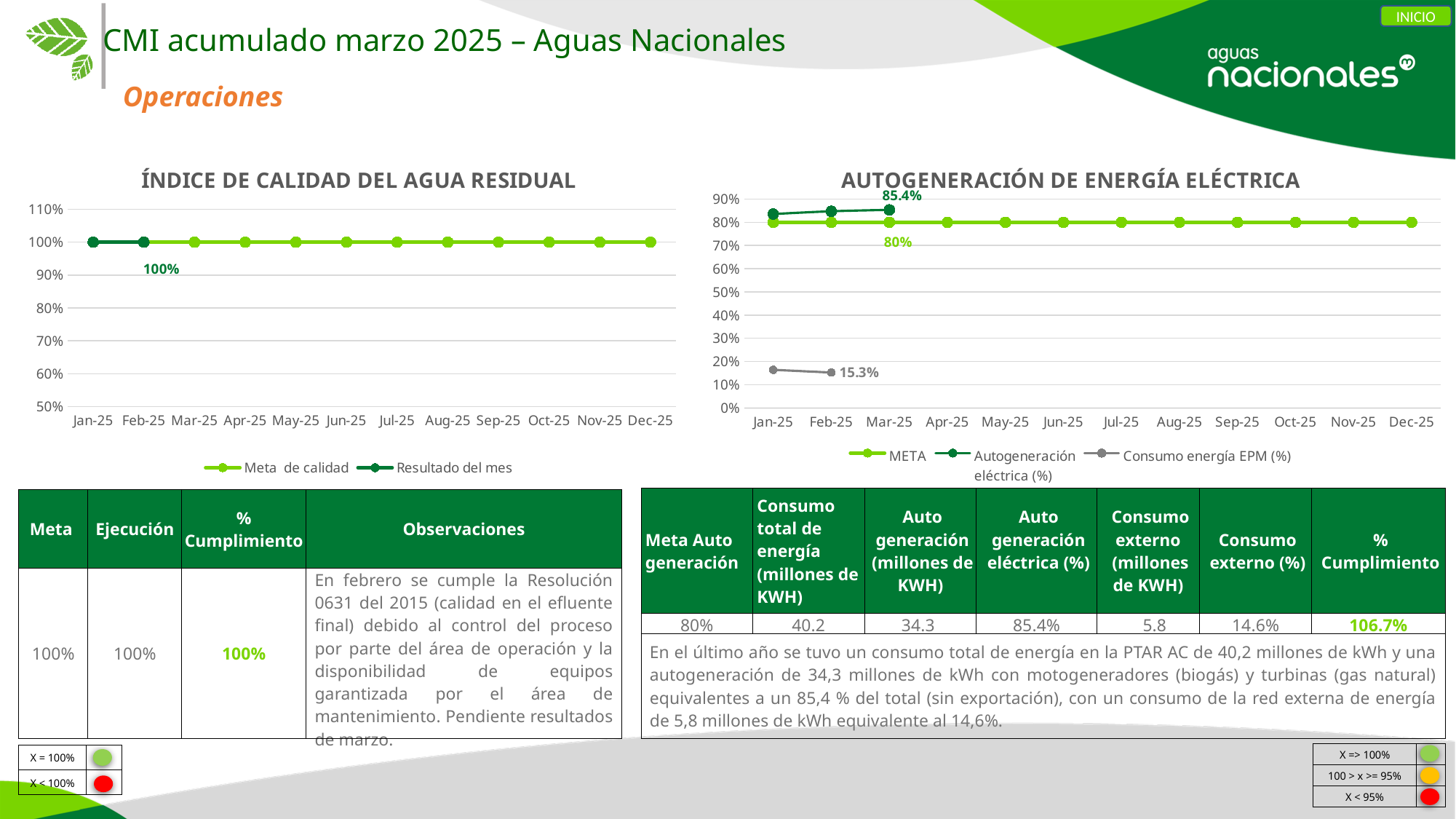
How many months are shown on the x axis of the 'ÍNDICE DE CALIDAD DEL AGUA RESIDUAL' chart? 12 In the 'AUTOGENERACIÓN DE ENERGÍA ELÉCTRICA' chart, what is the labelled value of 'Consumo energía EPM (%)' in Feb-25? 15.3% How many series does the legend of the 'AUTOGENERACIÓN DE ENERGÍA ELÉCTRICA' chart list? 3 In the 'ÍNDICE DE CALIDAD DEL AGUA RESIDUAL' chart, what is the labelled value of 'Resultado del mes' in Feb-25? 100% What kind of chart is the 'ÍNDICE DE CALIDAD DEL AGUA RESIDUAL' chart? Line chart In the 'AUTOGENERACIÓN DE ENERGÍA ELÉCTRICA' chart, which is higher in Mar-25: 'Autogeneración eléctrica (%)' or META? Autogeneración eléctrica (%) How many series does the legend of the 'ÍNDICE DE CALIDAD DEL AGUA RESIDUAL' chart list? 2 In the 'AUTOGENERACIÓN DE ENERGÍA ELÉCTRICA' chart, does the META line rise, fall or stay flat from Jan-25 to Dec-25? Stays flat In the 'AUTOGENERACIÓN DE ENERGÍA ELÉCTRICA' chart, what is the labelled value of the META line? 80% In the 'AUTOGENERACIÓN DE ENERGÍA ELÉCTRICA' chart, is the value for 'Consumo energía EPM (%)' in Jan-25 greater or less than 20%? less In the 'AUTOGENERACIÓN DE ENERGÍA ELÉCTRICA' chart, by how much does the Mar-25 'Autogeneración eléctrica (%)' value exceed the META value? 5.4% In the 'AUTOGENERACIÓN DE ENERGÍA ELÉCTRICA' chart, what is the labelled value of 'Autogeneración eléctrica (%)' in Mar-25? 85.4%